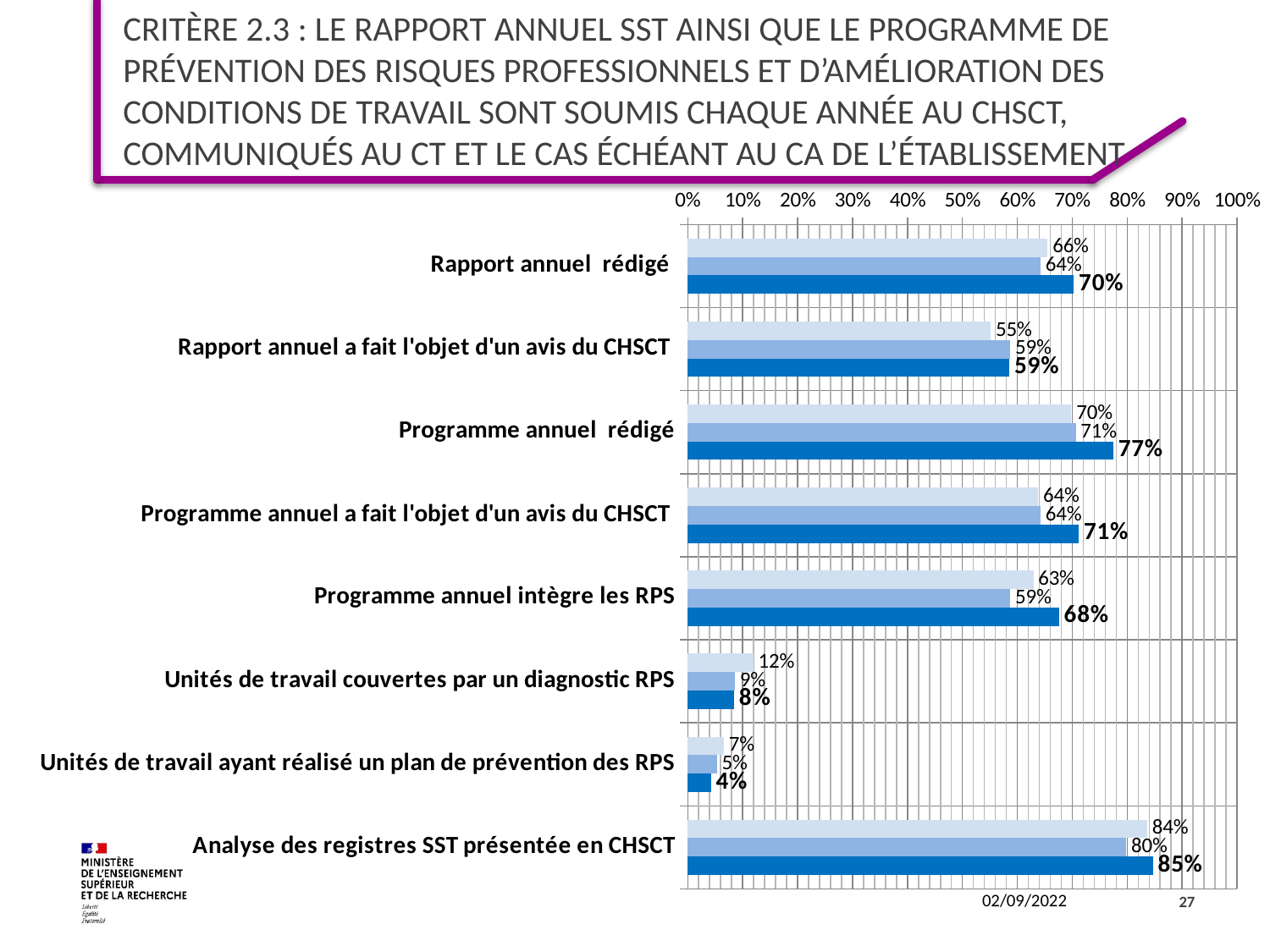
What is the value of the light blue (top) bar for "Analyse des registres SST présentée en CHSCT"? 84% What is the value of the light blue (top) bar for "Programme annuel intègre les RPS"? 63% What is the value of the middle bar for "Unités de travail couvertes par un diagnostic RPS"? 9% What kind of chart is shown on the slide? bar chart How many categories are shown on the chart? 8 For "Programme annuel rédigé", what is the difference between the dark blue (bottom) bar and the light blue (top) bar? 7 percentage points Which has the larger dark blue (bottom) bar value: "Programme annuel rédigé" or "Programme annuel a fait l'objet d'un avis du CHSCT"? Programme annuel rédigé Which category has the lowest value for the dark blue (bottom) bar? Unités de travail ayant réalisé un plan de prévention des RPS What is the value of the dark blue (bottom) bar for "Rapport annuel rédigé"? 70% Which category has the highest value for the dark blue (bottom) bar? Analyse des registres SST présentée en CHSCT How many bars are shown for each category? 3 Is the dark blue (bottom) bar for "Analyse des registres SST présentée en CHSCT" greater or less than 80%? greater